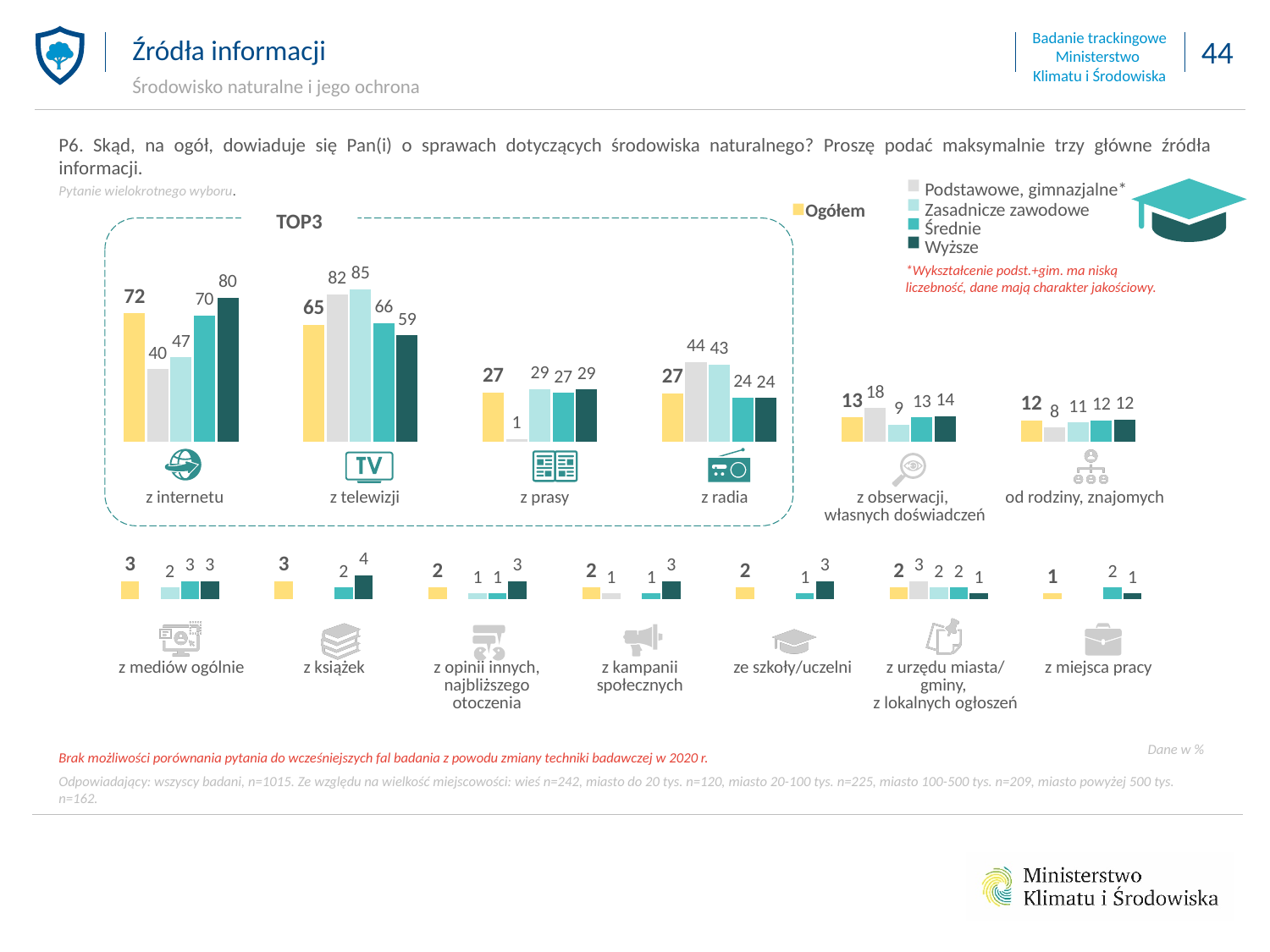
How many information sources (categories) are shown on the chart? 13 How many series does the legend list? 5 What is the Ogółem value for 'z internetu'? 72 What kind of chart is shown on the slide? bar chart What is the value for the Wyższe series for 'z internetu'? 80 What is the difference between the Wyższe and Podstawowe, gimnazjalne values for 'z internetu'? 40 For 'z radia', which is larger: the Podstawowe, gimnazjalne value or the Wyższe value? Podstawowe, gimnazjalne What is the Podstawowe, gimnazjalne value for 'z prasy'? 1 What is the Zasadnicze zawodowe value for 'z telewizji'? 85 Which source has the lowest Ogółem value? z miejsca pracy Which source has the highest Ogółem value? z internetu